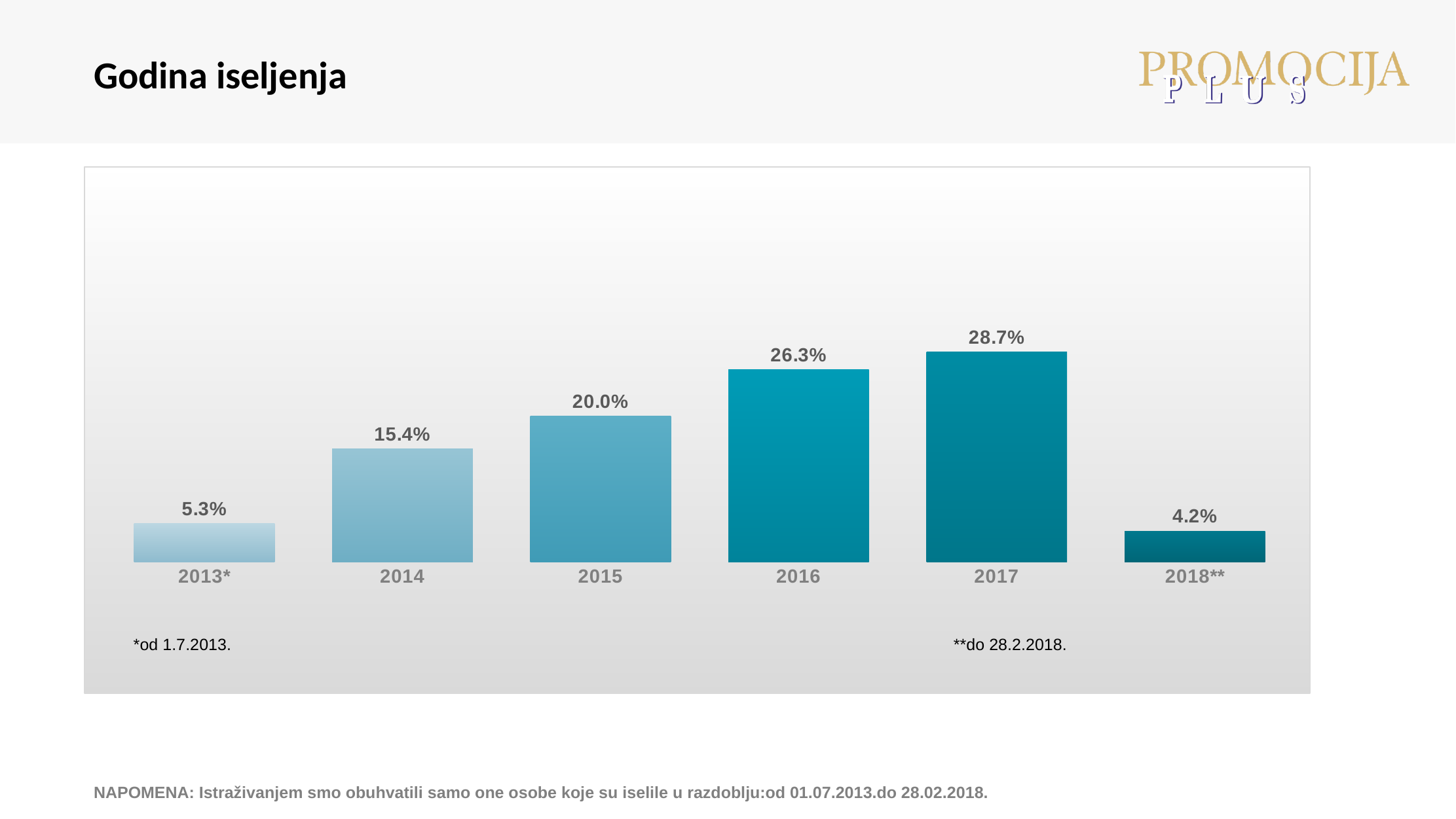
How many years are shown on the x axis? 6 Do the values rise or fall from 2013* to 2017? rise What is the value for 2018**? 4.2% What kind of chart is shown on the slide? bar chart What is the value for 2013*? 5.3% What is the difference between the values for 2015 and 2014? 4.6% Which year has the highest value? 2017 Which is larger, the value for 2014 or the value for 2016? 2016 What is the value for 2015? 20.0% What is the difference between the values for 2017 and 2016? 2.4% What is the title of the slide? Godina iseljenja Which year has the lowest value? 2018**